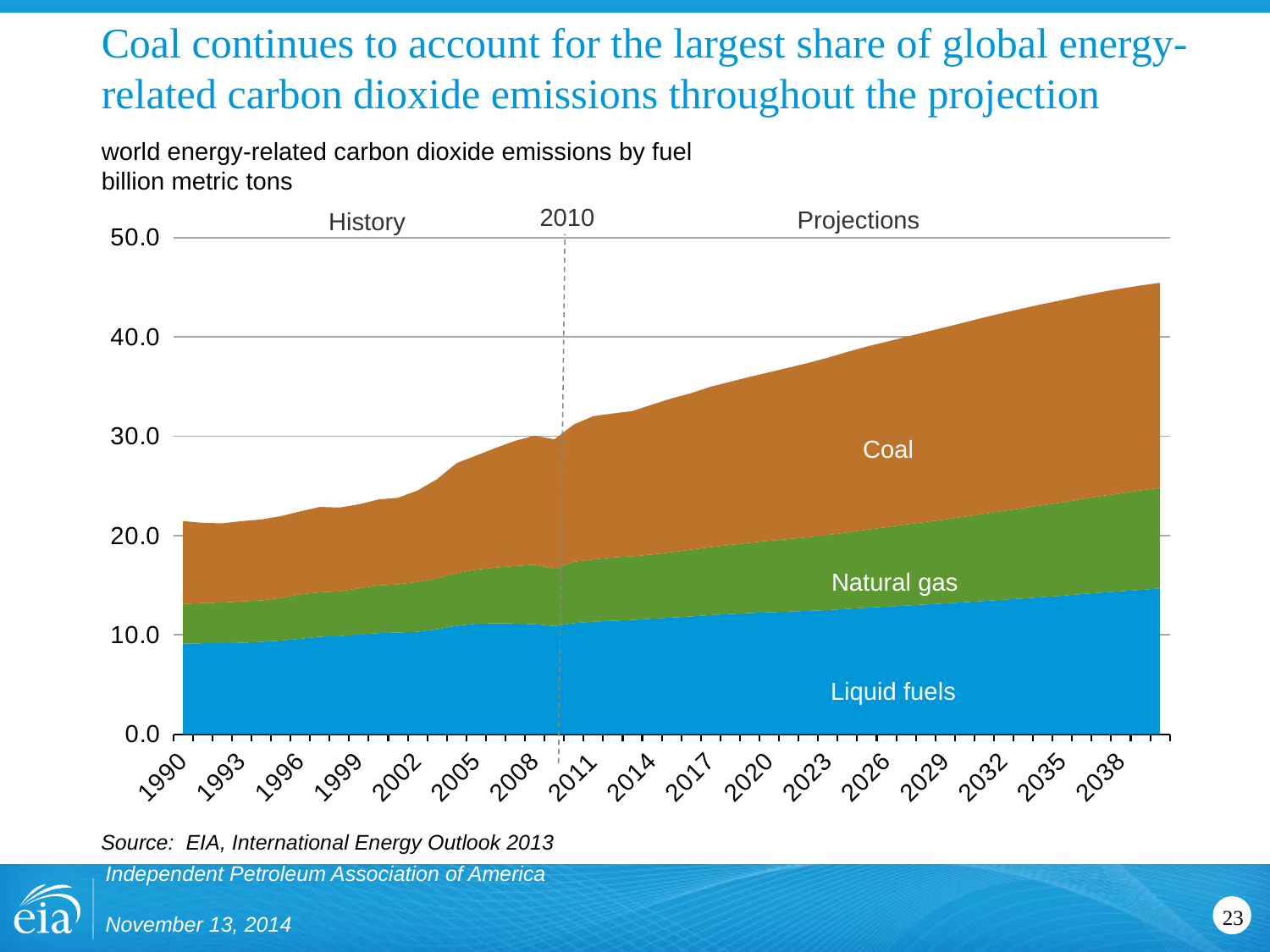
What kind of chart is shown on the slide? Stacked area chart In what units are the emissions measured in the chart? billion metric tons How many fuel series are shown in the chart? 3 Which fuel accounts for the largest share of emissions in 2038? Coal Is the total emissions value in 1990 greater or less than 30? less Is the total emissions value in 2038 greater or less than 50? less In 1990, which is larger: emissions from coal or from natural gas? Coal Is the total emissions value in 2020 greater or less than 30? greater Do total world energy-related carbon dioxide emissions rise or fall from 1990 to 2040? Rise Which fuel accounts for the smallest share of emissions in 2038? Natural gas What year does the dashed vertical line separating History from Projections mark? 2010